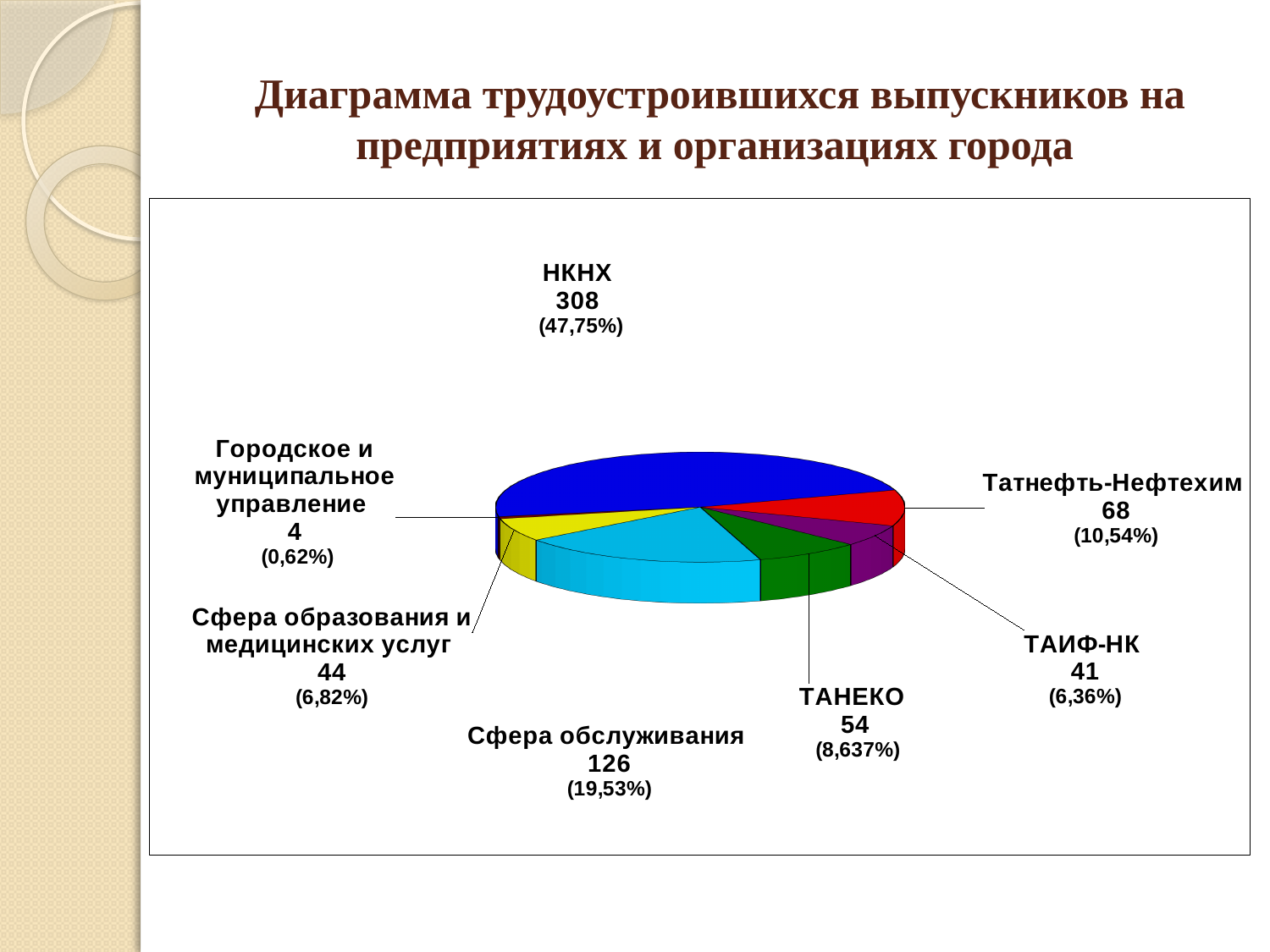
How many slices does the pie chart have? 7 What kind of chart is shown on the slide? pie chart What is the value for Сфера обслуживания? 126 What colour is the НКНХ slice? blue What share of the pie does ТАИФ-НК have? 6,36% What share of the pie does Татнефть-Нефтехим have? 10,54% What is the difference between the values for НКНХ and Сфера обслуживания? 182 Which category has the largest value? НКНХ What is the value for ТАНЕКО? 54 Which category has the smallest value? Городское и муниципальное управление What is the value for НКНХ? 308 Which is larger, the value for Татнефть-Нефтехим or the value for Сфера образования и медицинских услуг? Татнефть-Нефтехим